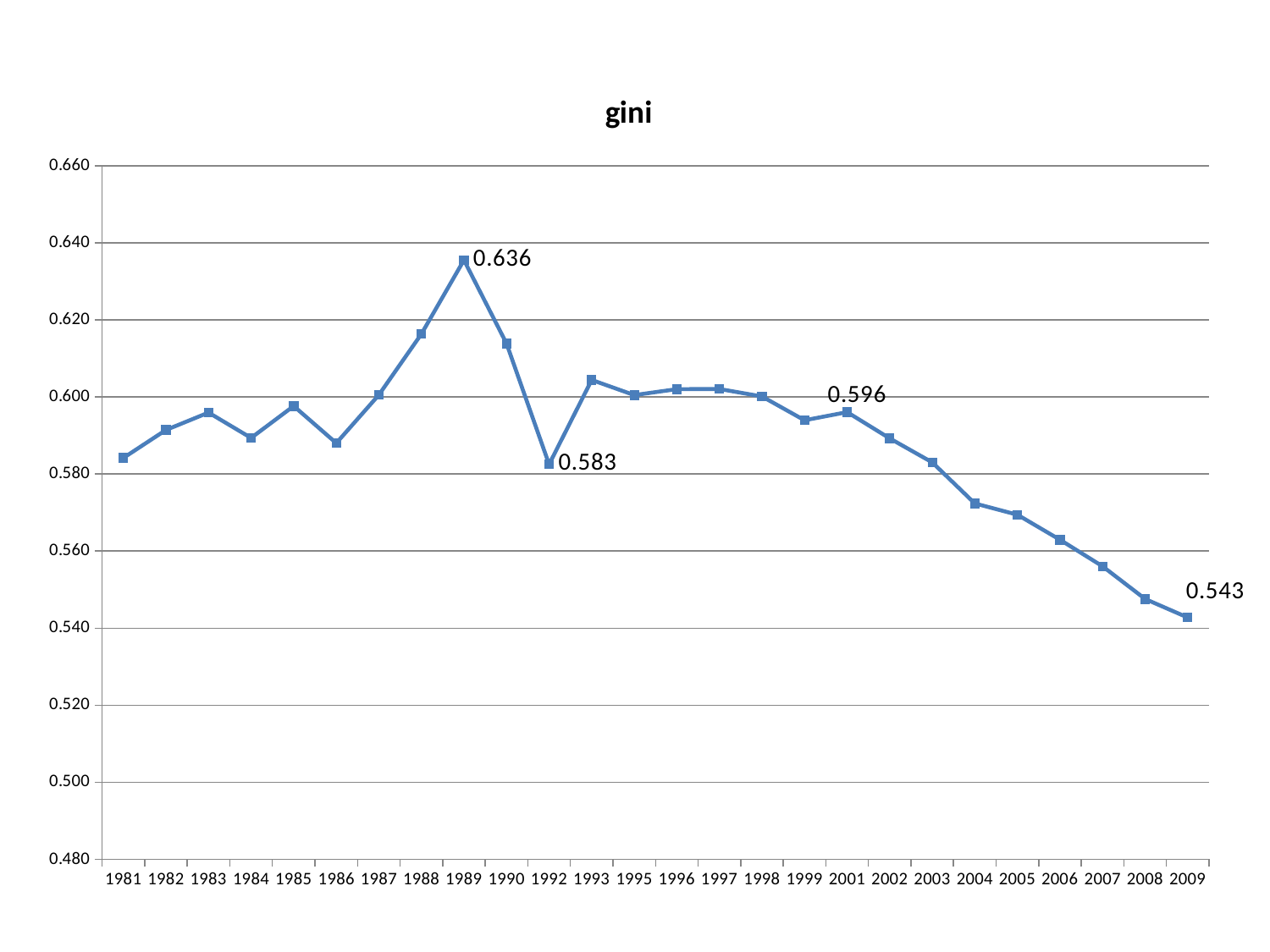
How many years are plotted on the x axis? 26 What is the gini value for 2009? 0.543 What is the gini value for 1989? 0.636 Is the gini value for 1988 greater or less than 0.600? greater What is the gini value for 2001? 0.596 What is the difference between the gini value in 1989 and in 2009? 0.093 What is the gini value for 1992? 0.583 Which year has the lowest gini value? 2009 Which is larger, the gini value in 1992 or in 2001? 2001 Which year has the highest gini value? 1989 Is the gini value for 2004 greater or less than 0.580? less What kind of chart is shown on the slide? line chart